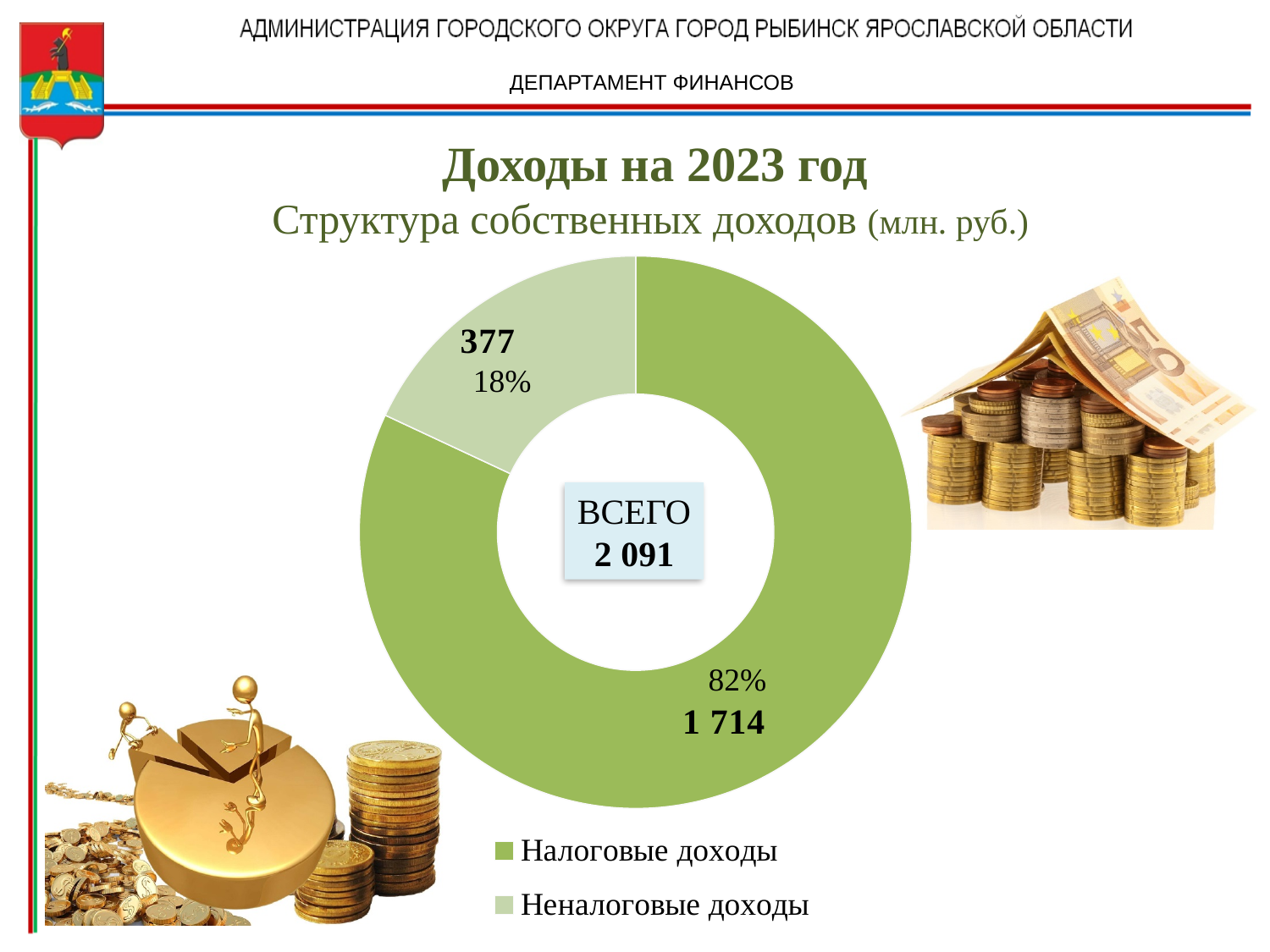
What is the total (ВСЕГО) shown in the centre of the chart? 2 091 What share of the pie does Налоговые доходы take? 82% Which is larger, Налоговые доходы or Неналоговые доходы? Налоговые доходы Which category is the largest? Налоговые доходы What share of the pie does Неналоговые доходы take? 18% What is the value for Неналоговые доходы? 377 Which category is the smallest? Неналоговые доходы What kind of chart is shown on the slide? Doughnut (pie) chart What is the value for Налоговые доходы? 1 714 How many categories does the chart show? 2 What is the subtitle of the chart? Структура собственных доходов (млн. руб.) What is the difference between Налоговые доходы and Неналоговые доходы? 1 337